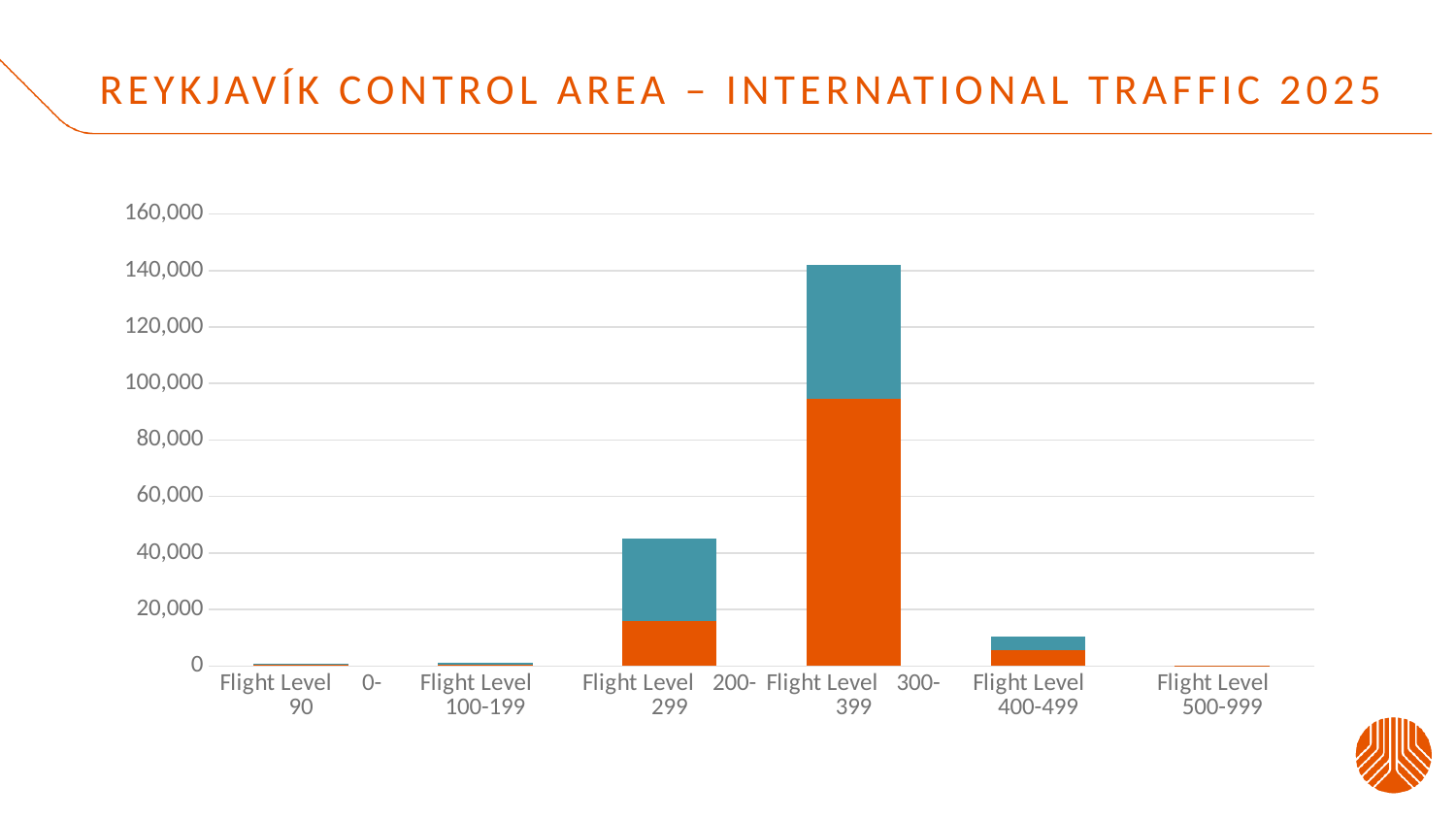
What kind of chart is shown on the slide? Stacked bar chart Is the total value for Flight Level 300-399 greater or less than 120,000? greater Which flight level category has the tallest bar? Flight Level 300-399 Is the total value for Flight Level 200-299 greater or less than 60,000? less How many flight level categories are shown on the x axis? 6 Do the bar totals rise or fall from Flight Level 300-399 to Flight Level 500-999? fall Is the orange segment for Flight Level 300-399 greater or less than 80,000? greater How many colours are used for the bar segments? 2 Which has a larger total, Flight Level 200-299 or Flight Level 400-499? Flight Level 200-299 What is the title of the chart? Reykjavík Control Area – International Traffic 2025